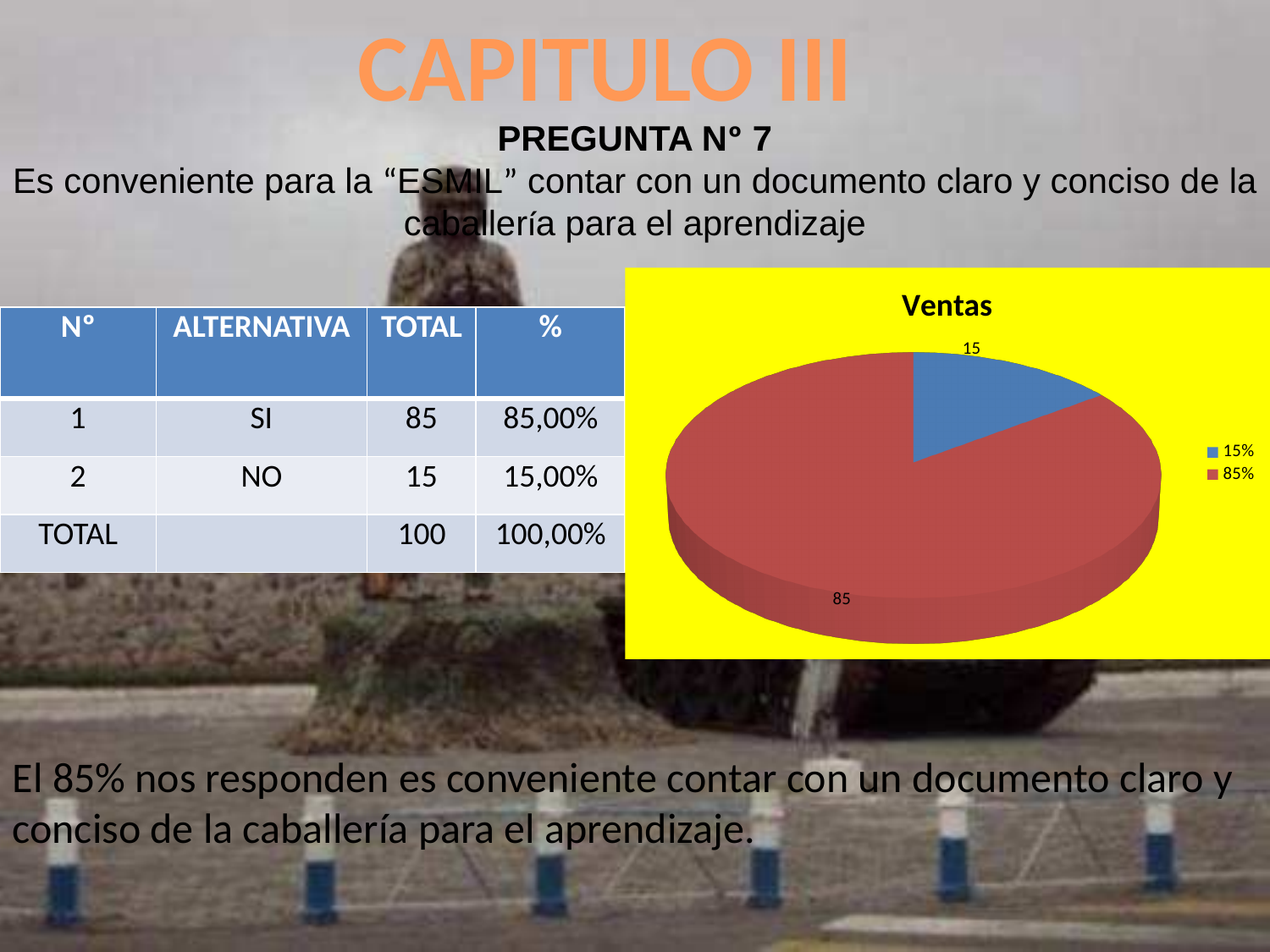
Which slice of the pie chart is the largest? 85% What share of the pie does the red slice represent? 85% What colour is the slice labelled 15% in the legend? blue What data label is shown on the blue slice of the pie chart? 15 What type of chart is shown on the slide? pie chart Which slice of the pie chart is the smallest? 15% What is the difference between the values of the red slice and the blue slice? 70 How many slices does the pie chart have? 2 Which is larger, the red slice or the blue slice? the red slice How many entries does the chart legend list? 2 What is the title of the chart? Ventas What data label is shown on the red slice of the pie chart? 85